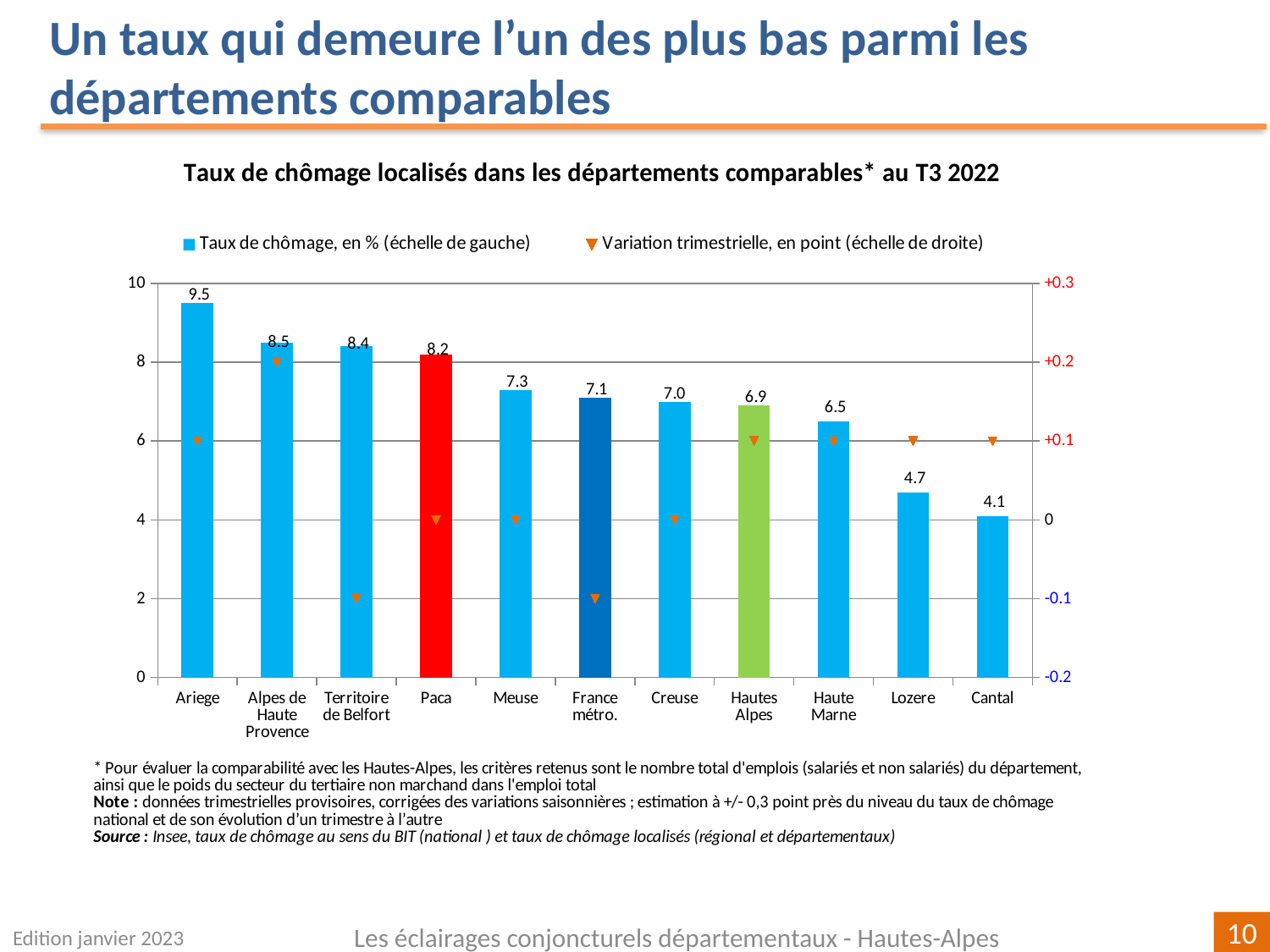
How many series does the legend list? 2 What is the unemployment rate (Taux de chômage) shown for Ariege? 9.5 Is the unemployment rate for Lozere greater or less than 6? less Which department has the lowest unemployment rate in the chart? Cantal What kind of chart is used to show the unemployment rates? bar chart Which has a higher unemployment rate, Meuse or Haute Marne? Meuse What is the quarterly variation shown for France métro. on the right-hand scale? -0.1 What is the unemployment rate shown for Hautes Alpes? 6.9 What is the quarterly variation (Variation trimestrielle) shown for Alpes de Haute Provence on the right-hand scale? +0.2 Which department has the highest unemployment rate in the chart? Ariege What is the difference between the unemployment rates of Ariege and Cantal? 5.4 How many departments/categories are shown on the x axis? 11